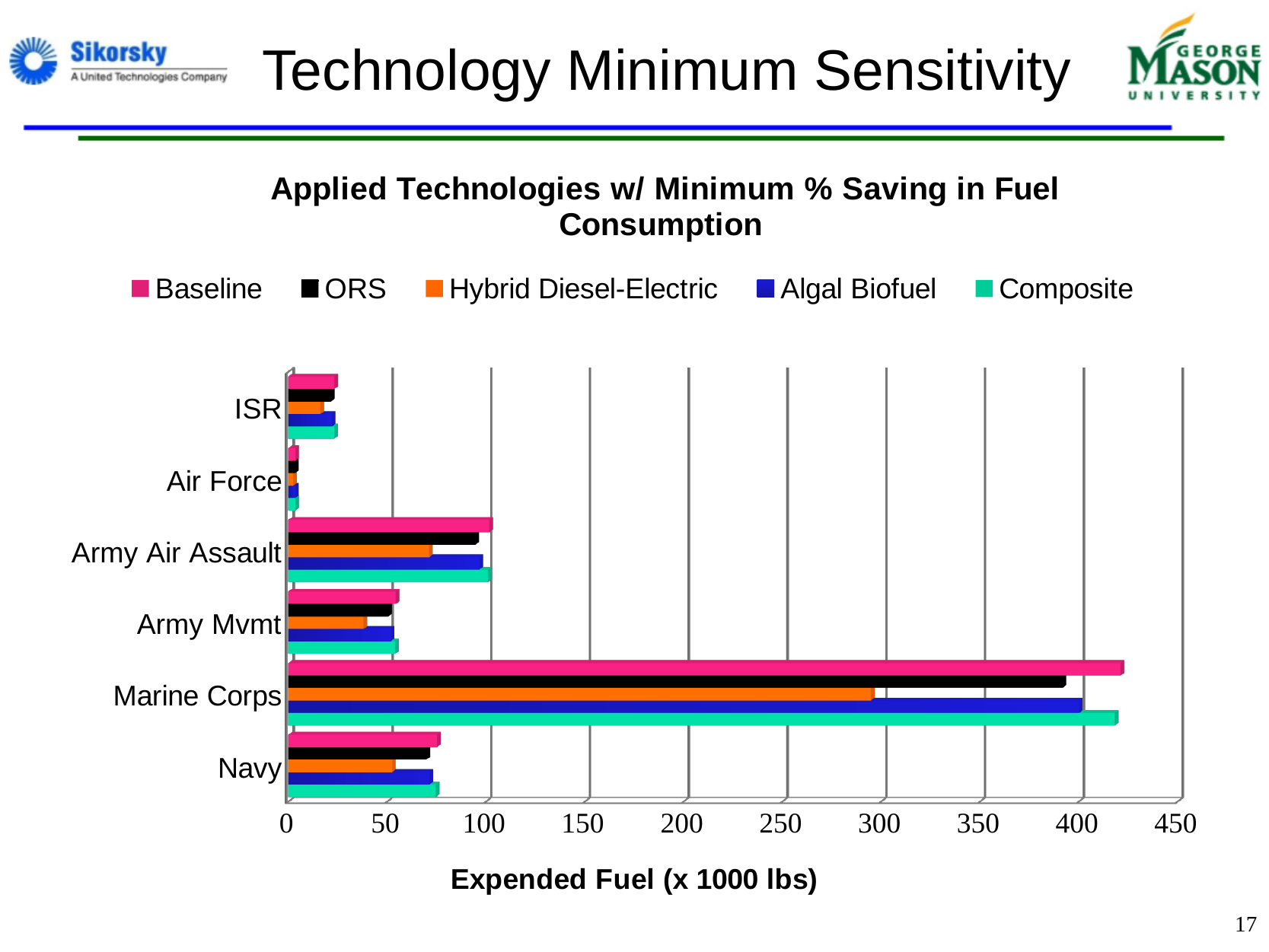
Which category has the lowest Baseline expended fuel? Air Force Is the Baseline value for Navy greater or less than 50? greater Which category has the highest Baseline expended fuel? Marine Corps How many categories are plotted on the y axis of the chart? 6 How many series does the chart legend list? 5 Is the Hybrid Diesel-Electric value for Marine Corps greater or less than 350? less For Marine Corps, which is larger: the Baseline value or the Hybrid Diesel-Electric value? Baseline What is the title of the x axis of the chart? Expended Fuel (x 1000 lbs) Is the Hybrid Diesel-Electric value for Army Air Assault greater or less than 100? less Which is larger: the Baseline value for Navy or the Baseline value for Army Mvmt? Navy What kind of chart is shown on the slide? bar chart